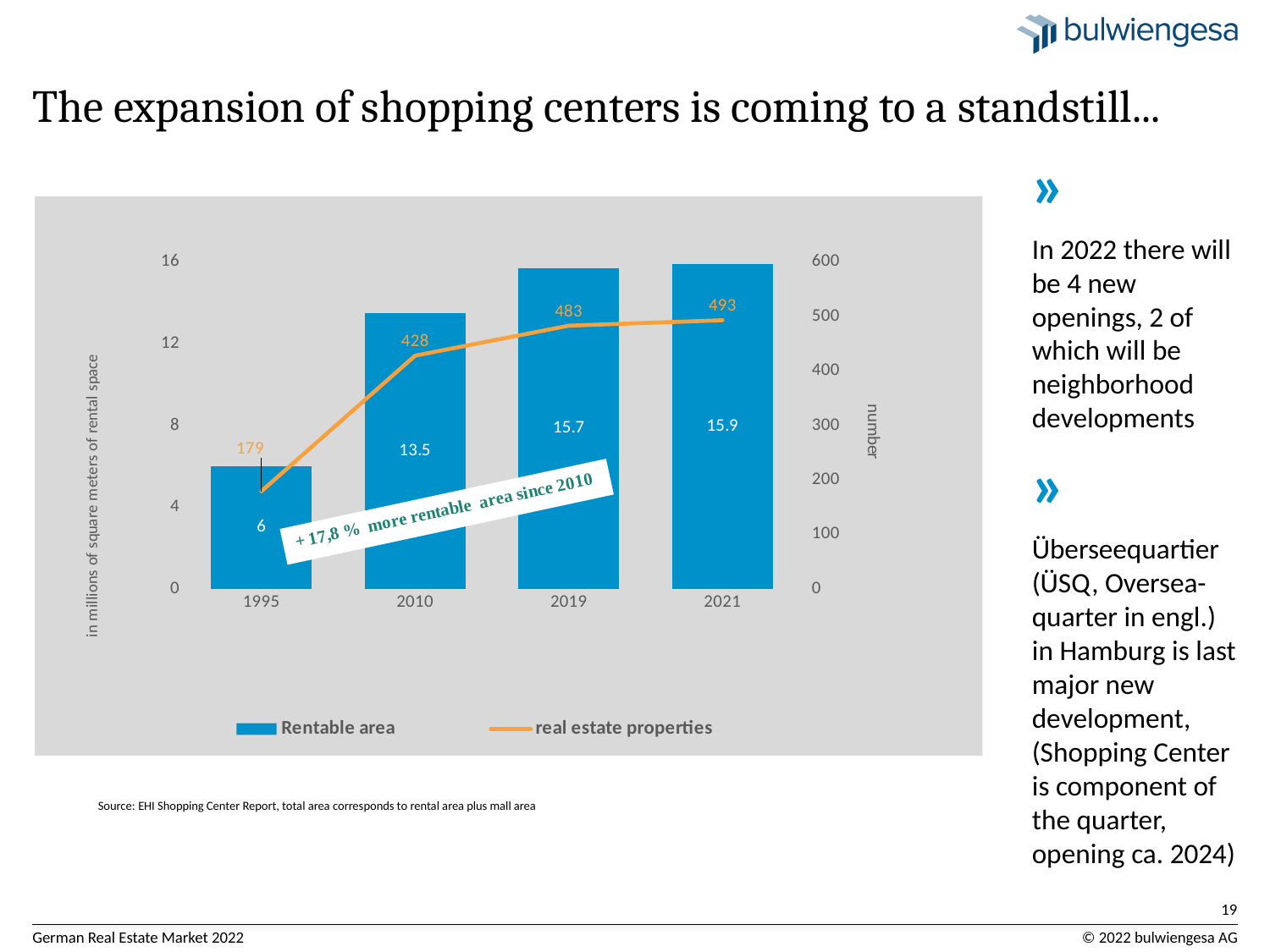
Which series is shown as a line rather than bars? real estate properties Which is larger, the rentable area in 2010 or in 2019? 2019 Which year has the highest number of real estate properties? 2021 What is the difference in the number of real estate properties between 2010 and 1995? 249 What is the number of real estate properties in 2019? 483 How many years are shown on the x axis? 4 How many series does the legend list? 2 Which year has the lowest rentable area? 1995 What is the rentable area value for 1995? 6 What is the rentable area value for 2010? 13.5 Does the number of real estate properties rise or fall from 1995 to 2021? rise What is the difference in rentable area between 2021 and 2019? 0.2